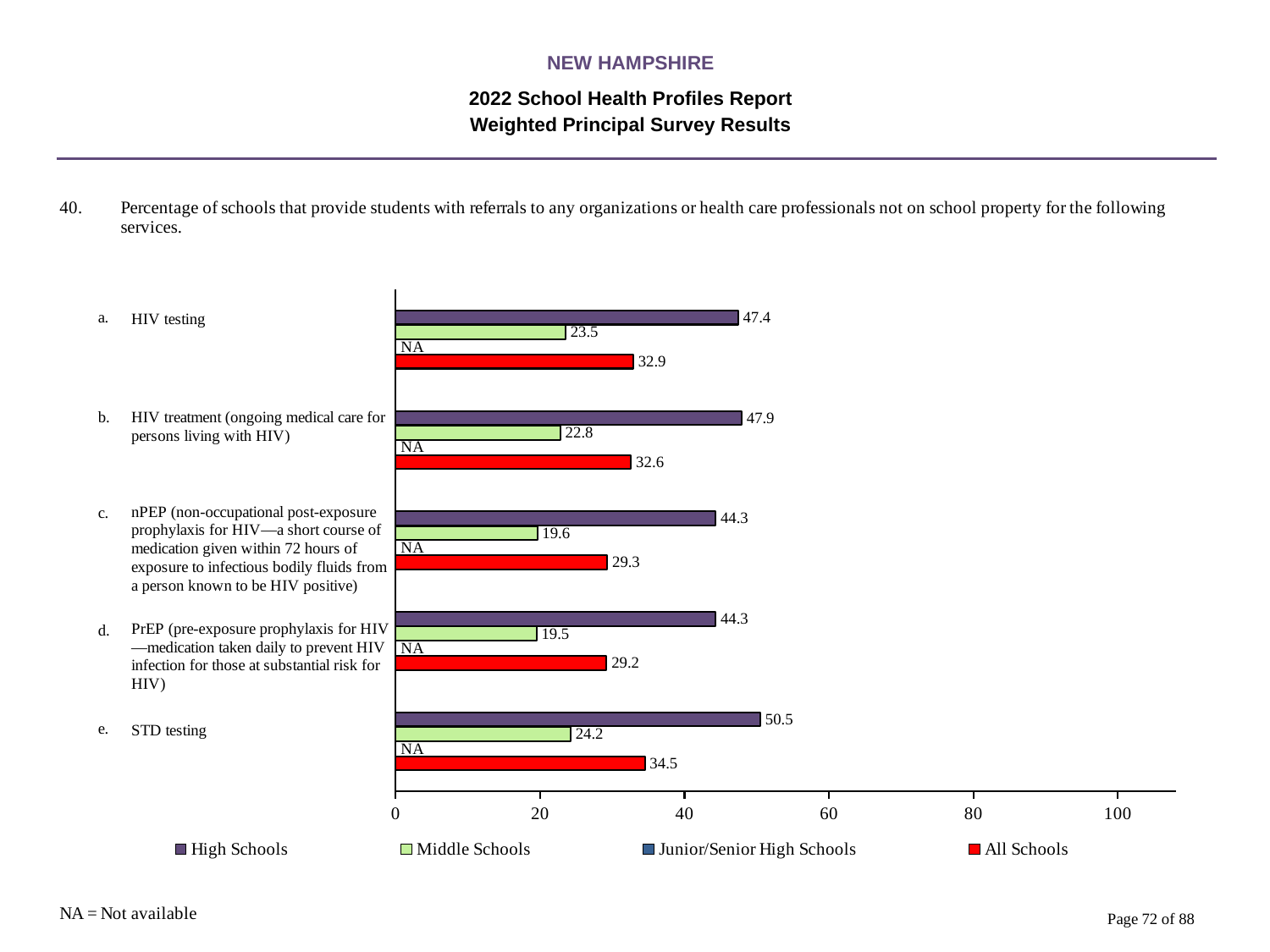
How many series does the legend list? 4 What is the All Schools value for HIV treatment? 32.6 What is the Middle Schools value for HIV testing? 23.5 Which is larger, the All Schools value for HIV testing or the All Schools value for STD testing? STD testing Which service has the lowest All Schools value? PrEP What is the Middle Schools value for PrEP? 19.5 What kind of chart is shown on the slide? Bar chart Which service has the highest High Schools value? STD testing What is the High Schools value for STD testing? 50.5 What is the difference between the High Schools and Middle Schools values for nPEP? 24.7 What value is shown for Junior/Senior High Schools for each service? NA How many services (categories) are shown in the chart? 5